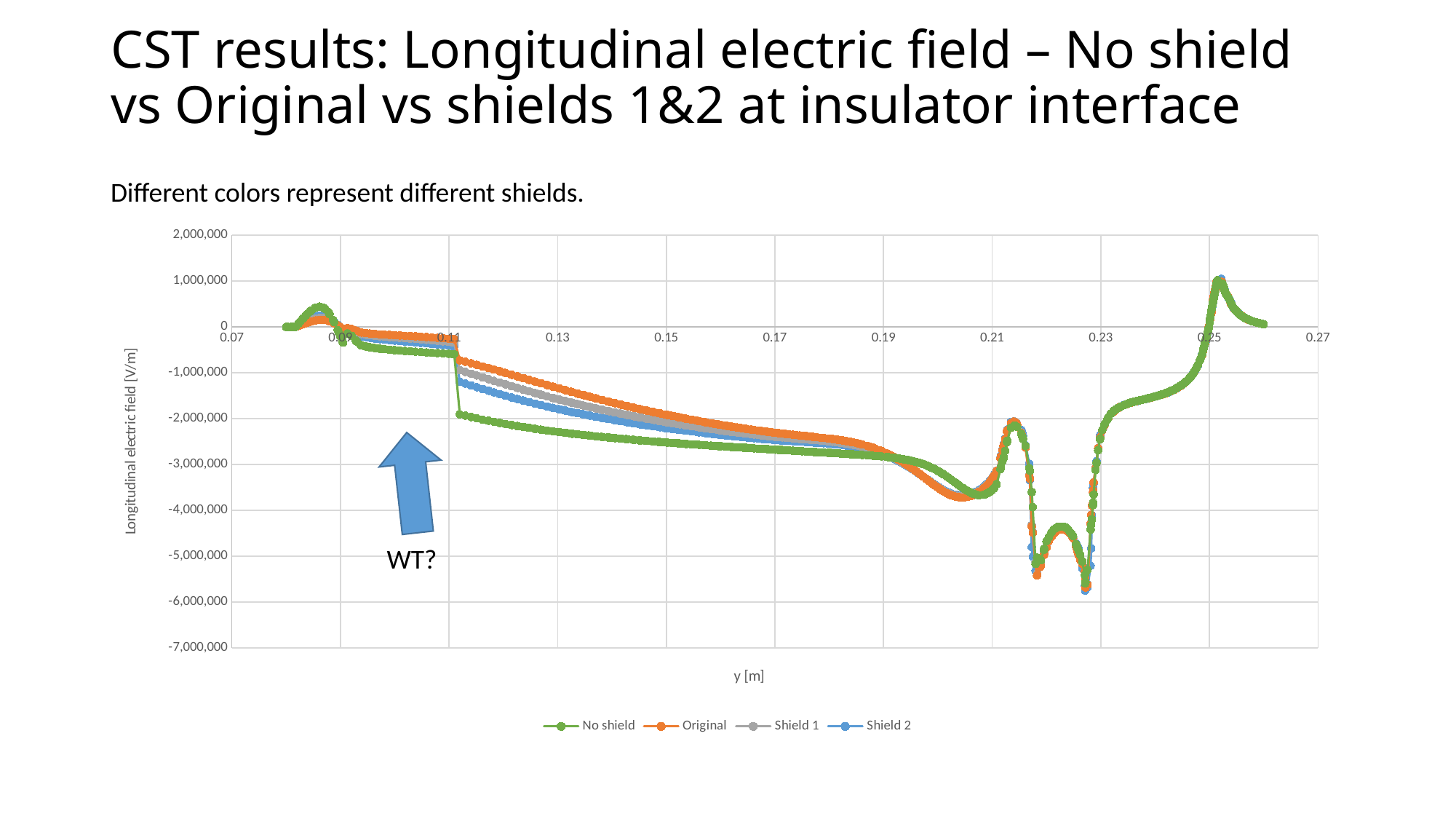
Between y = 0.23 m and y = 0.25 m, do the curves rise or fall? rise How many series does the chart legend list? 4 Is the lowest value reached by the curves (near y = 0.23 m) greater or less than -5,000,000? less Is the value of the No shield series at y = 0.15 m greater or less than -2,000,000? less Between y = 0.11 m and y = 0.19 m, do the values of the No shield series rise or fall? fall At y = 0.15 m, which series has the higher value, Original or No shield? Original At y = 0.13 m, which series has the higher value, Shield 1 or Shield 2? Shield 1 What are the four series named in the legend? No shield, Original, Shield 1, Shield 2 What kind of chart is shown on the slide? Line chart What is the label of the vertical axis? Longitudinal electric field [V/m] Is the peak of the No shield series near y = 0.085 m greater or less than 0? greater